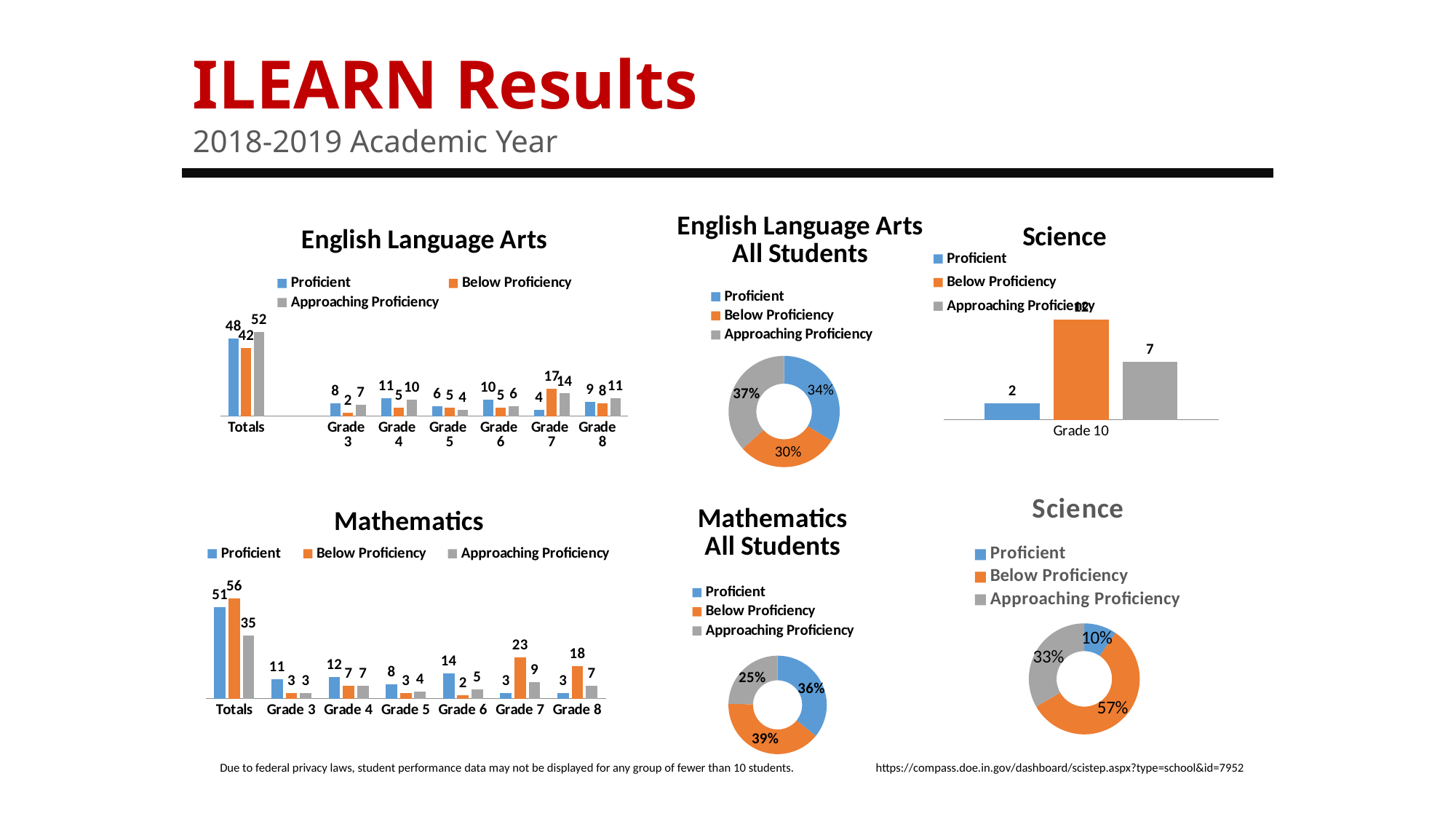
In the Science bar chart (top right), which series has the highest value for Grade 10? Below Proficiency In the English Language Arts All Students donut chart, what share is Approaching Proficiency? 37% In the Science bar chart (top right), what is the Proficient value for Grade 10? 2 In the English Language Arts bar chart, what is the Below Proficiency value for Grade 7? 17 In the Mathematics bar chart, is the Proficient value for Grade 6 larger or the Proficient value for Grade 4? Grade 6 In the Science donut chart (bottom right), what share is Proficient? 10% In the English Language Arts bar chart, what is the difference between the Proficient and Below Proficiency values for Totals? 6 In the Mathematics bar chart, which grade has the highest Below Proficiency value? Grade 7 In the English Language Arts bar chart, what is the Approaching Proficiency value for Totals? 52 How many series does the legend of the Mathematics bar chart list? 3 In the Mathematics bar chart, what is the Below Proficiency value for Totals? 56 In the Mathematics All Students donut chart, what share is Below Proficiency? 39%